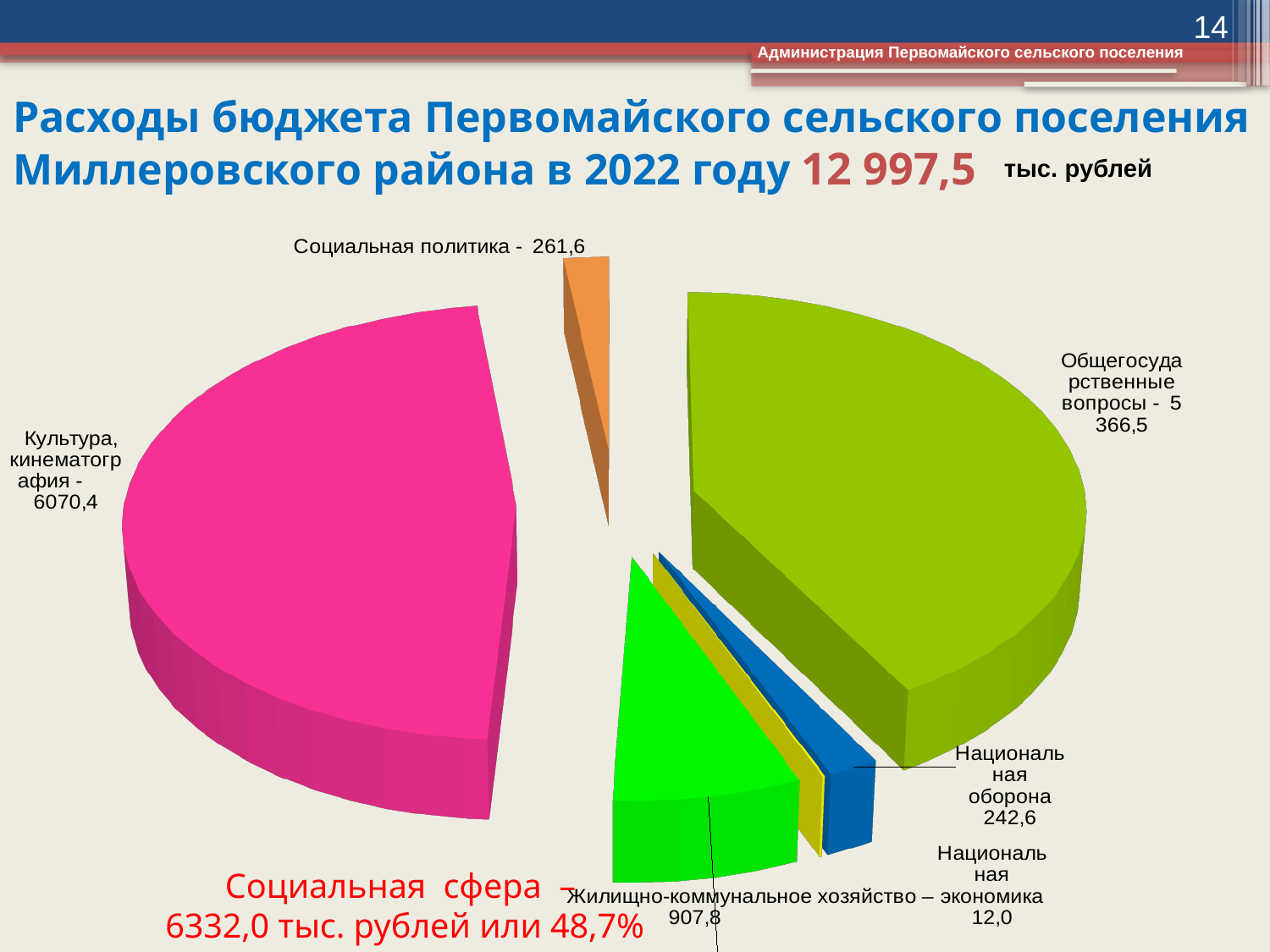
Which is larger: Социальная политика or Национальная оборона? Социальная политика Which category has the largest slice of the pie? Культура, кинематография What is the value for Общегосударственные вопросы? 5 366,5 What colour is the slice for Культура, кинематография? Pink What total budget expenditure is stated in the slide title? 12 997,5 тыс. рублей How many slices (categories) does the pie chart have? 6 What is the value for Культура, кинематография? 6070,4 What is the difference between Культура, кинематография and Общегосударственные вопросы? 703,9 What is the value for Жилищно-коммунальное хозяйство? 907,8 What is the value for Национальная оборона? 242,6 Which category has the smallest slice of the pie? Национальная экономика What kind of chart is shown on the slide? Pie chart